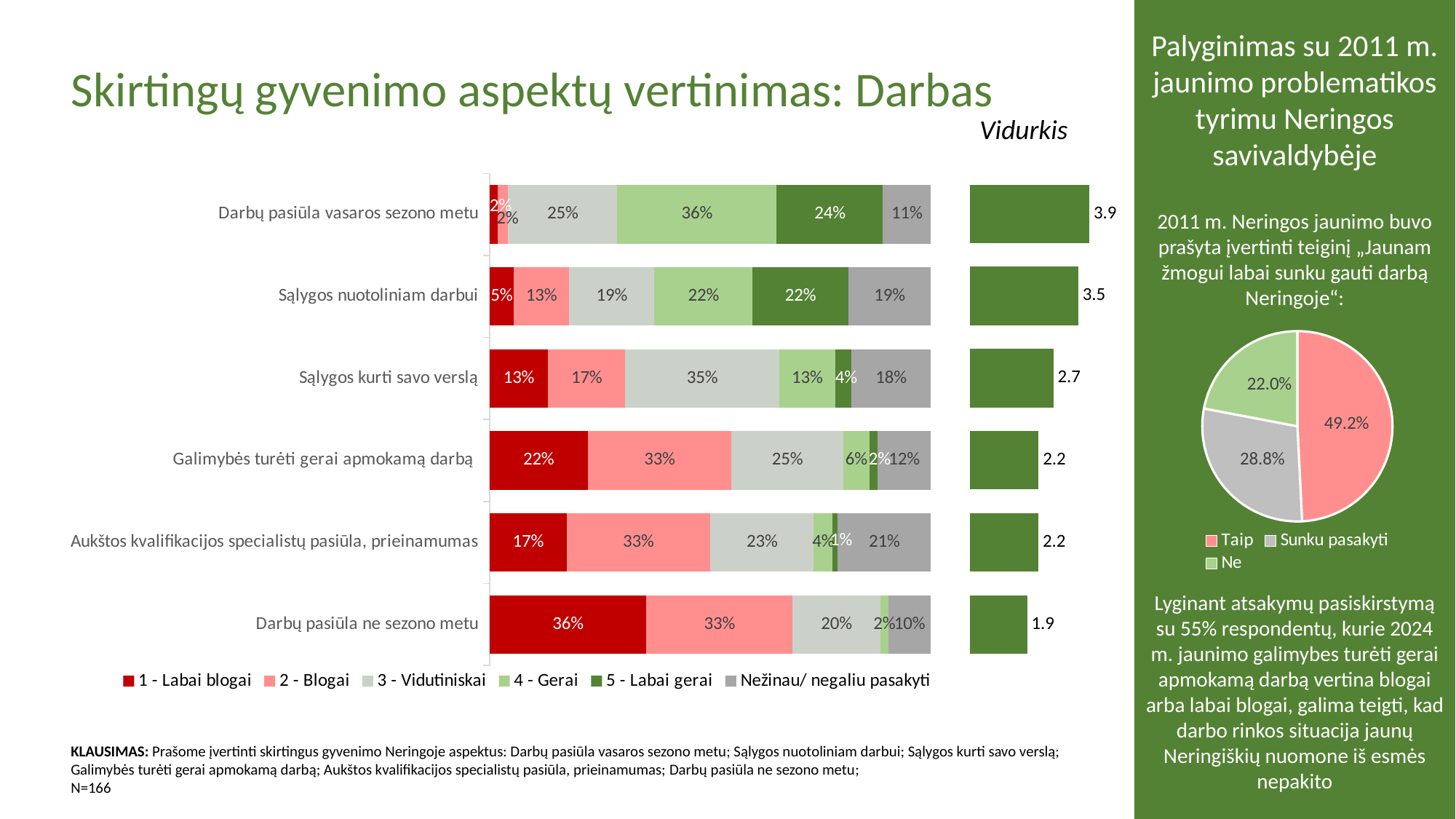
In the stacked bar chart, which is larger: the '5 - Labai gerai' share for 'Darbų pasiūla vasaros sezono metu' or for 'Sąlygos kurti savo verslą'? Darbų pasiūla vasaros sezono metu How many series does the legend of the stacked bar chart list? 6 In the 'Vidurkis' chart, what is the difference between the highest and lowest average values? 2.0 How many categories are shown in the stacked bar chart? 6 What kind of chart is shown on the right-hand green panel? Pie chart In the pie chart on the right, what share of respondents answered 'Taip'? 49.2% In the stacked bar chart, what is the difference between the '3 - Vidutiniskai' share for 'Sąlygos kurti savo verslą' and for 'Sąlygos nuotoliniam darbui'? 16% In the stacked bar chart, what percentage of respondents rated 'Darbų pasiūla vasaros sezono metu' as '4 - Gerai'? 36% In the stacked bar chart, what percentage rated 'Darbų pasiūla ne sezono metu' as '1 - Labai blogai'? 36% In the 'Vidurkis' chart, which category has the lowest average? Darbų pasiūla ne sezono metu In the stacked bar chart, which category has the highest share of '1 - Labai blogai' responses? Darbų pasiūla ne sezono metu In the 'Vidurkis' chart, what is the average value for 'Sąlygos nuotoliniam darbui'? 3.5